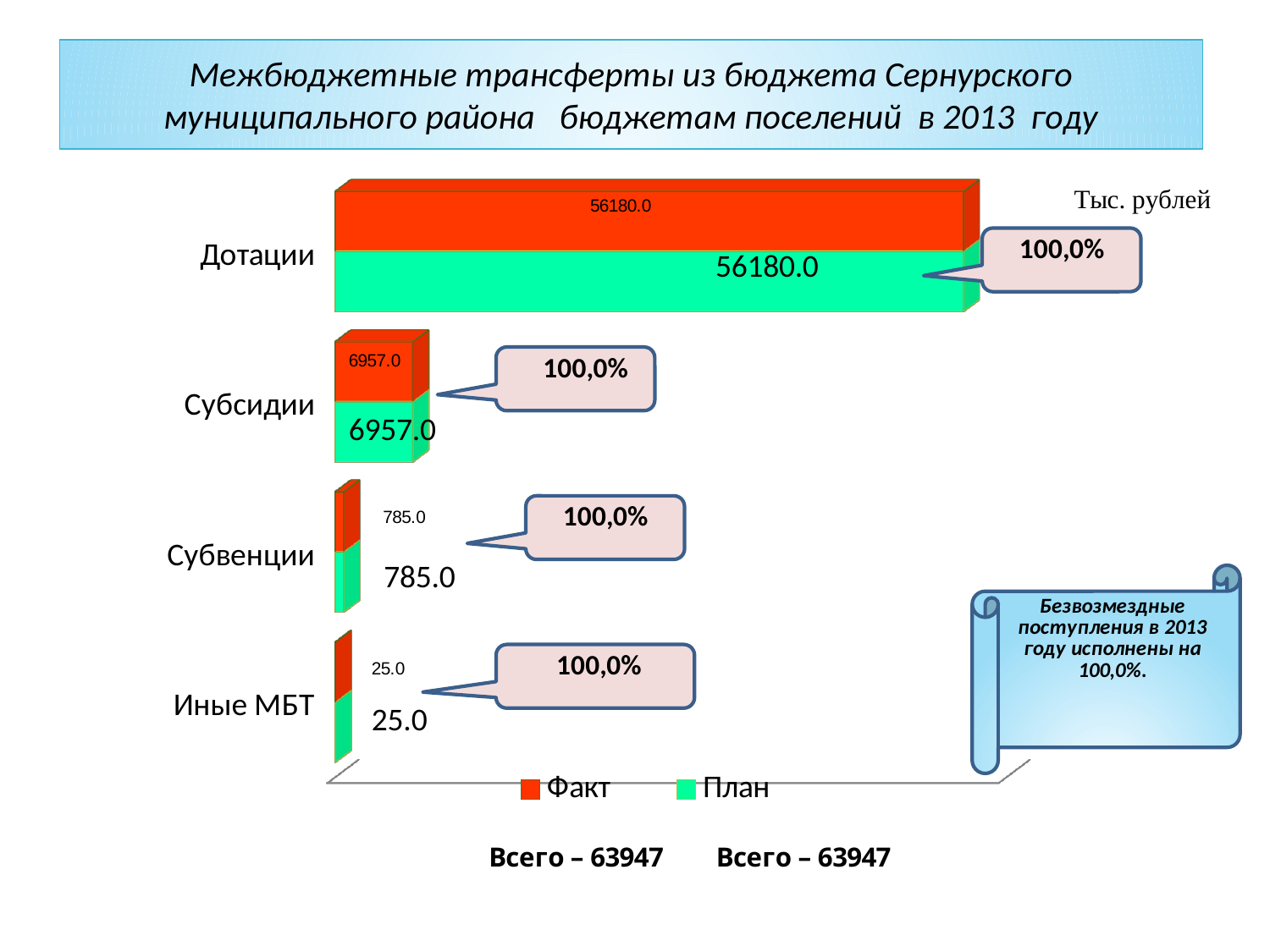
Which category has the highest Факт value? Дотации What is the difference between the Факт values for Субсидии and Субвенции? 6172.0 How many series does the legend list? 2 Which colour represents the Факт series in the legend? Red What is the План value for Иные МБТ? 25.0 Which category has the lowest План value? Иные МБТ What is the Факт value for Субвенции? 785.0 How many categories are shown on the chart? 4 Which is larger, the План value for Субвенции or the План value for Иные МБТ? Субвенции What kind of chart is shown on the slide? Bar chart What is the Факт value for Дотации? 56180.0 What is the План value for Субсидии? 6957.0